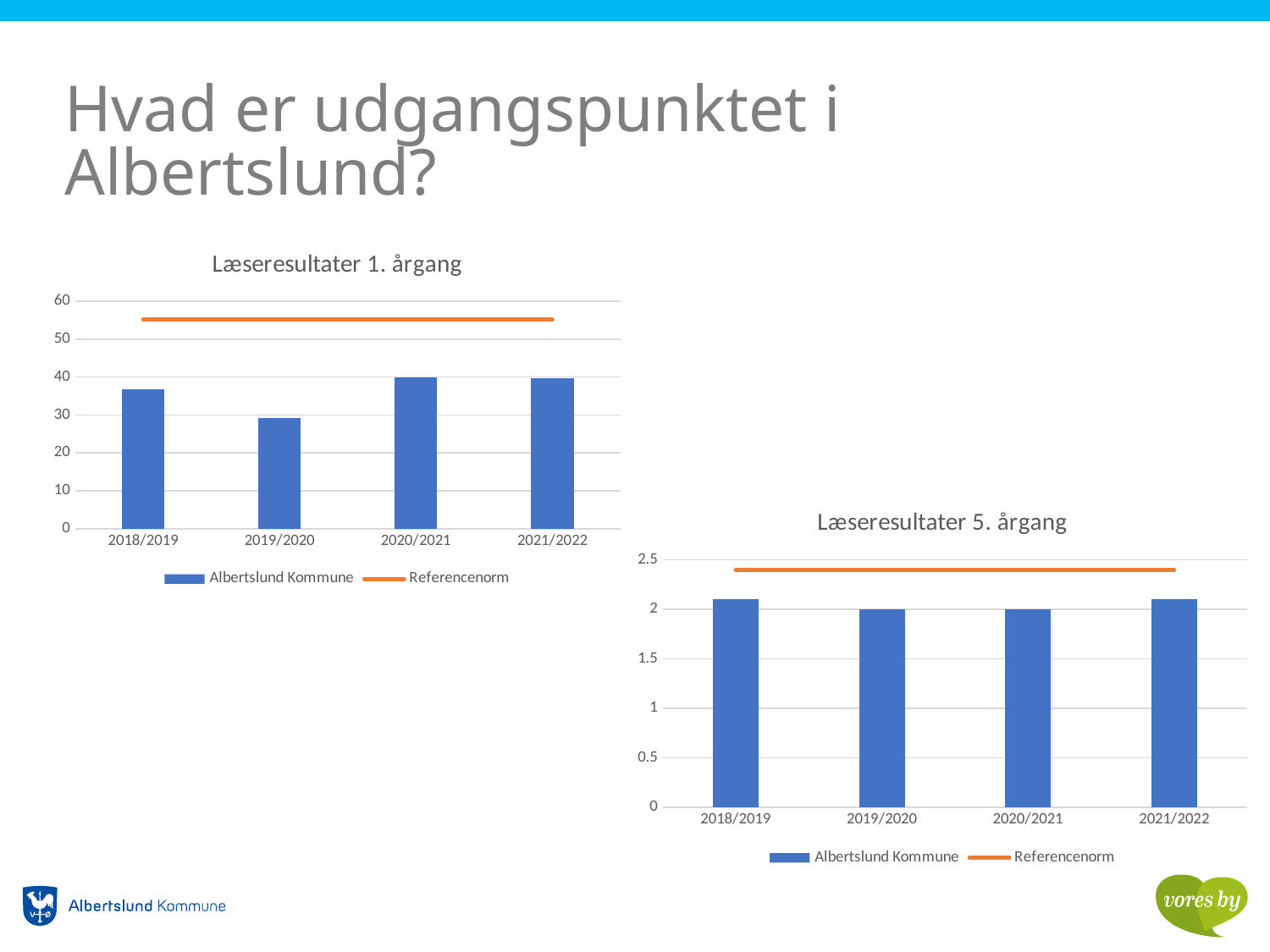
In "Læseresultater 1. årgang", is the Albertslund Kommune value for 2020/2021 greater or less than 30? greater How many school years are shown on the x axis of "Læseresultater 1. årgang"? 4 How many series does the legend of "Læseresultater 5. årgang" list? 2 What are the two legend entries in "Læseresultater 5. årgang"? Albertslund Kommune and Referencenorm What is the title of the chart on the right side of the slide? Læseresultater 5. årgang In "Læseresultater 5. årgang", is the Albertslund Kommune value for 2018/2019 greater or less than 1.5? greater In "Læseresultater 1. årgang", is the Albertslund Kommune value for 2019/2020 greater or less than 30? less In "Læseresultater 1. årgang", which is larger for Albertslund Kommune: 2018/2019 or 2019/2020? 2018/2019 What kind of chart is "Læseresultater 1. årgang"? bar chart In "Læseresultater 1. årgang", which school year has the lowest value for Albertslund Kommune? 2019/2020